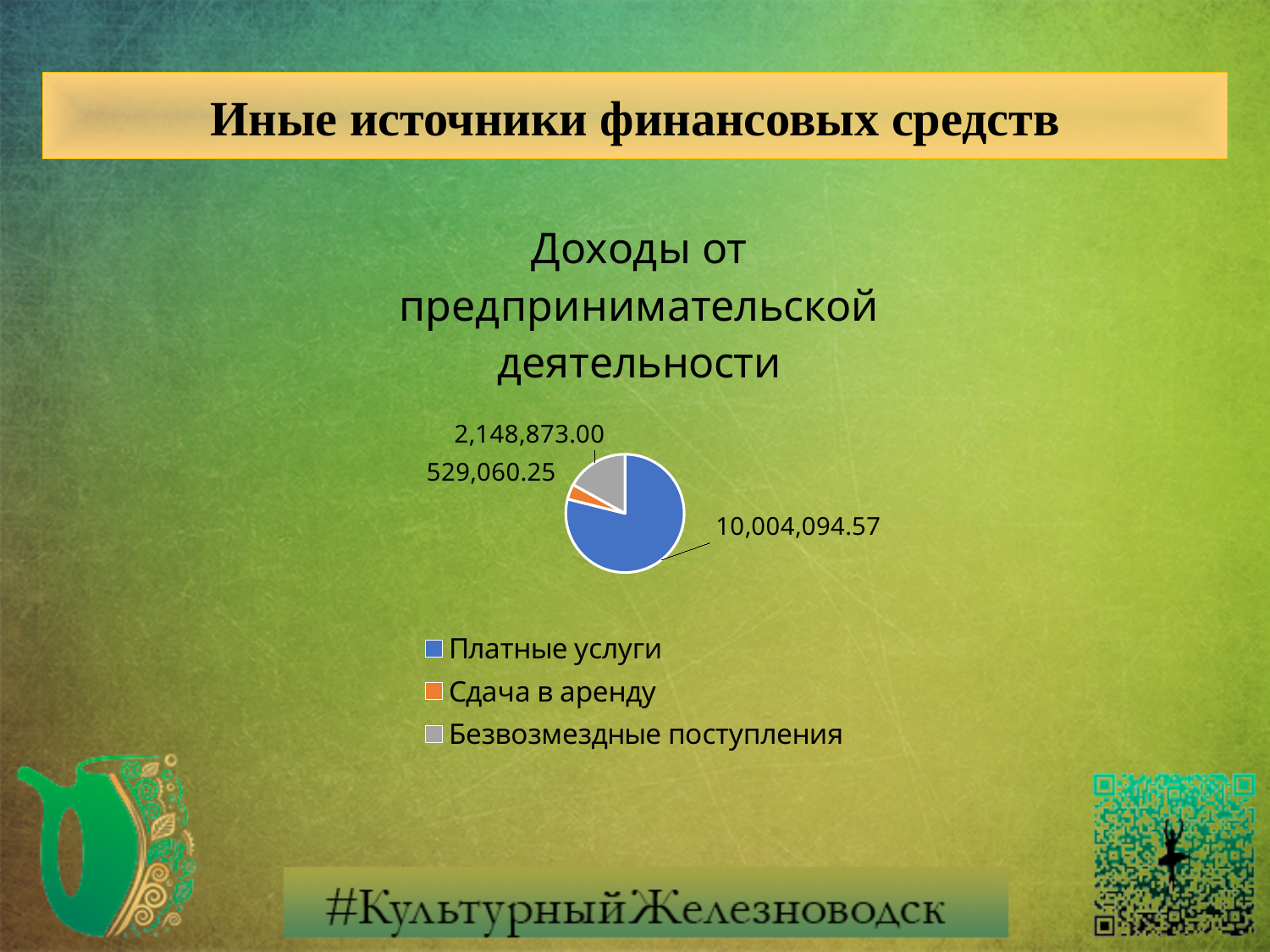
Which is larger, Безвозмездные поступления or Сдача в аренду? Безвозмездные поступления What is the value for Безвозмездные поступления? 2,148,873.00 What is the difference between Безвозмездные поступления and Сдача в аренду? 1,619,812.75 What is the value for Сдача в аренду? 529,060.25 What is the title of the chart? Доходы от предпринимательской деятельности What is the value for Платные услуги? 10,004,094.57 How many categories does the pie chart have? 3 Which colour represents Безвозмездные поступления in the legend? gray Which category has the smallest slice of the pie? Сдача в аренду Which category has the largest slice of the pie? Платные услуги What is the difference between Платные услуги and Сдача в аренду? 9,475,034.32 What type of chart is shown on the slide? pie chart